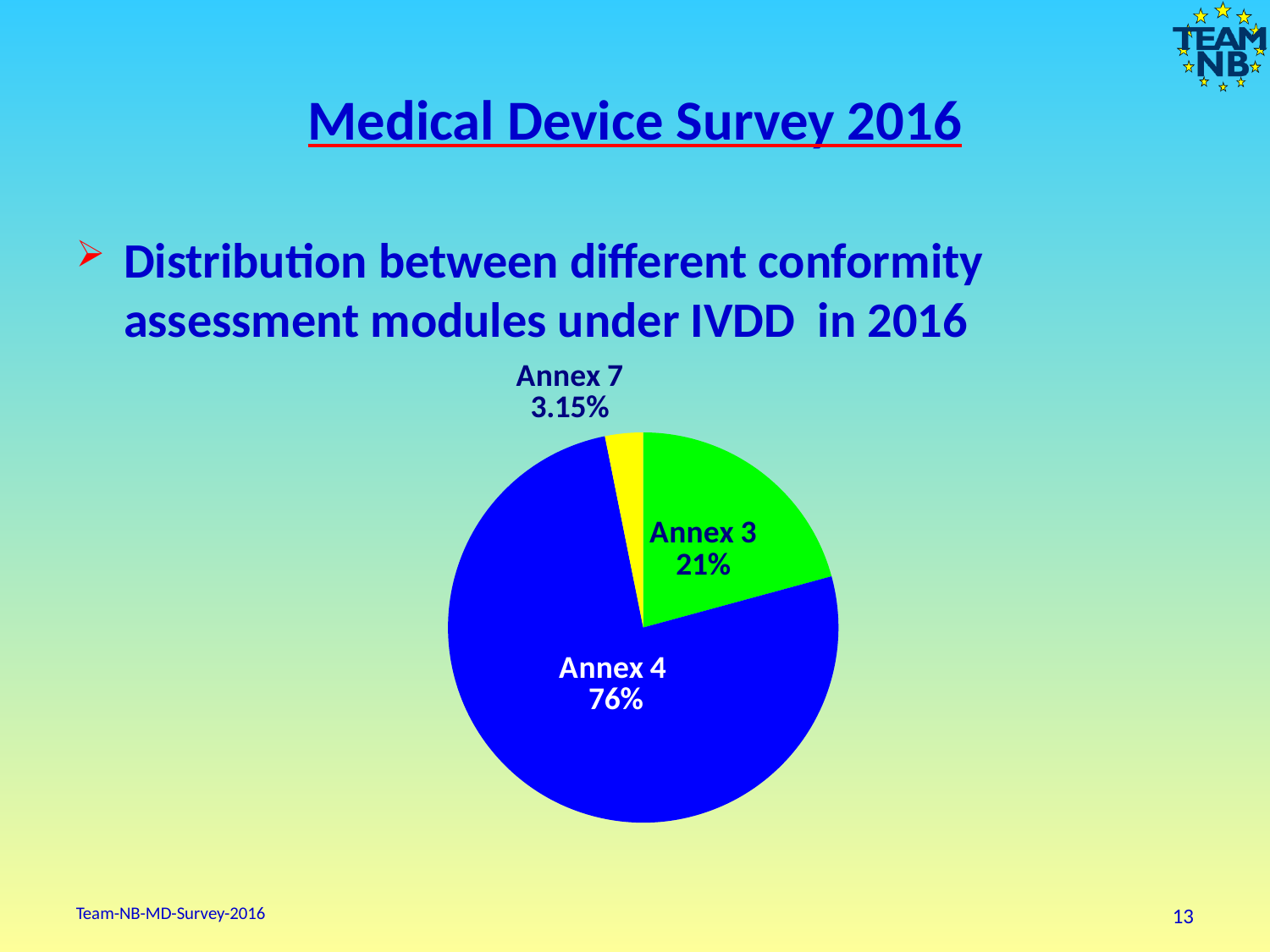
Which annex has the smallest slice of the pie? Annex 7 Which is larger, the share for Annex 3 or the share for Annex 7? Annex 3 Which annex has the largest slice of the pie? Annex 4 What share of the pie does Annex 3 represent? 21% What share of the pie does Annex 7 represent? 3.15% What is the difference in percentage points between the Annex 4 share and the Annex 3 share? 55 percentage points What colour is the Annex 4 slice? Blue How many slices does the pie chart have? 3 What colour is the Annex 7 slice? Yellow What share of the pie does Annex 4 represent? 76% What kind of chart is shown on the slide? Pie chart